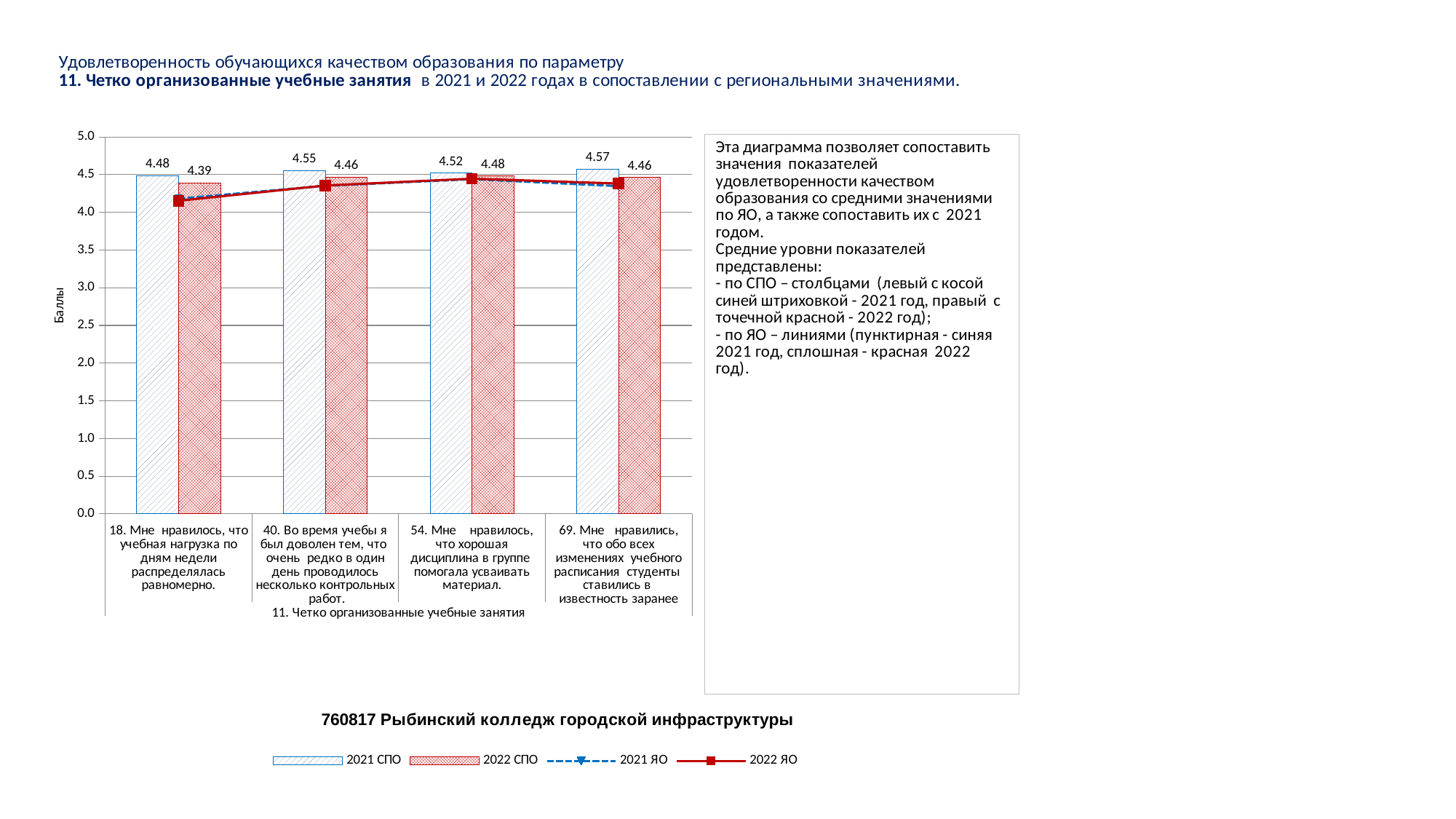
What is the difference between the 2021 СПО and 2022 СПО values for category 69? 0.11 Which category has the lowest 2022 СПО value? 18. Мне нравилось, что учебная нагрузка по дням недели распределялась равномерно Which category has the highest 2021 СПО value? 69. Мне нравились, что обо всех изменениях учебного расписания студенты ставились в известность заранее What is the 2021 СПО value for category 18 ("Мне нравилось, что учебная нагрузка по дням недели распределялась равномерно")? 4.48 How many series does the legend list? 4 How many categories are shown on the x axis? 4 Is the 2022 ЯО value for category 18 greater or less than 4.5? less For category 54, which is larger: the 2021 СПО value or the 2022 СПО value? 2021 СПО What is the label of the vertical axis? Баллы What is the 2022 СПО value for category 54 ("Мне нравилось, что хорошая дисциплина в группе помогала усваивать материал")? 4.48 What kind of chart is shown on the slide? Combined bar and line chart What is the 2022 СПО value for category 40 ("Во время учебы я был доволен тем, что очень редко в один день проводилось несколько контрольных работ")? 4.46